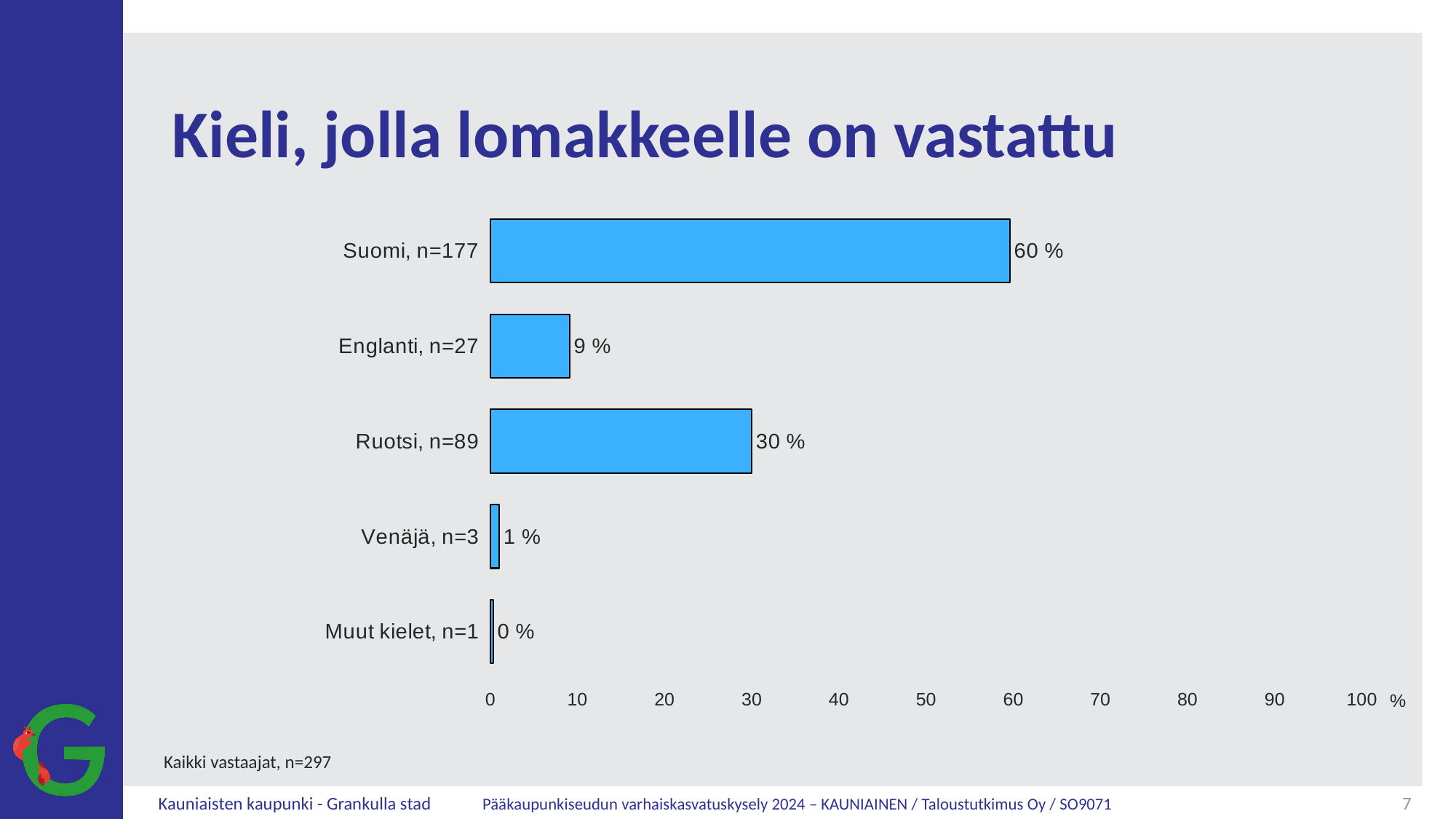
Which is larger, the value for Englanti, n=27 or Ruotsi, n=89? Ruotsi, n=89 What is the value for Ruotsi, n=89? 30 % What is the title of the chart? Kieli, jolla lomakkeelle on vastattu Which category has the highest value? Suomi, n=177 What is the value for Venäjä, n=3? 1 % What is the value for Englanti, n=27? 9 % Is the value for Suomi, n=177 greater or less than 50? greater Which category has the lowest value? Muut kielet, n=1 What is the difference between the values for Suomi, n=177 and Ruotsi, n=89? 30 % What is the value for Suomi, n=177? 60 % How many categories are shown in the chart? 5 What kind of chart is shown on the slide? bar chart